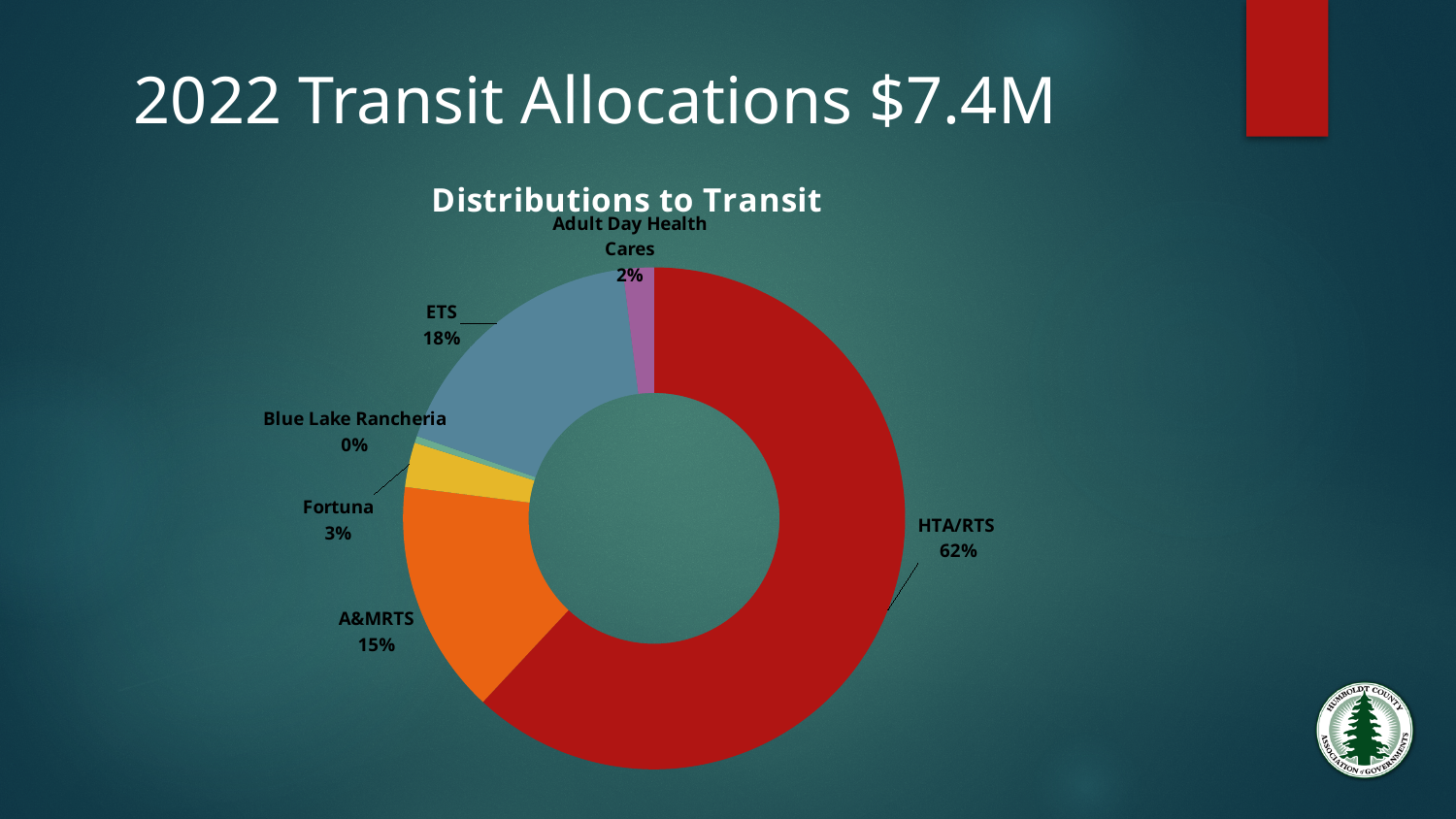
How many percentage points larger is the ETS share than the A&MRTS share? 3 What share of the Distributions to Transit chart goes to HTA/RTS? 62% What percentage is shown for A&MRTS? 15% What percentage is shown for Blue Lake Rancheria? 0% What kind of chart is used to show the Distributions to Transit? Pie chart (doughnut) What percentage is shown for Fortuna? 3% Which is larger, the share for Fortuna or the share for Adult Day Health Cares? Fortuna What percentage is shown for ETS in the Distributions to Transit chart? 18% Which category receives the largest share of the distributions? HTA/RTS What percentage is shown for Adult Day Health Cares? 2% Which category receives the smallest share of the distributions? Blue Lake Rancheria How many categories are shown in the Distributions to Transit chart? 6